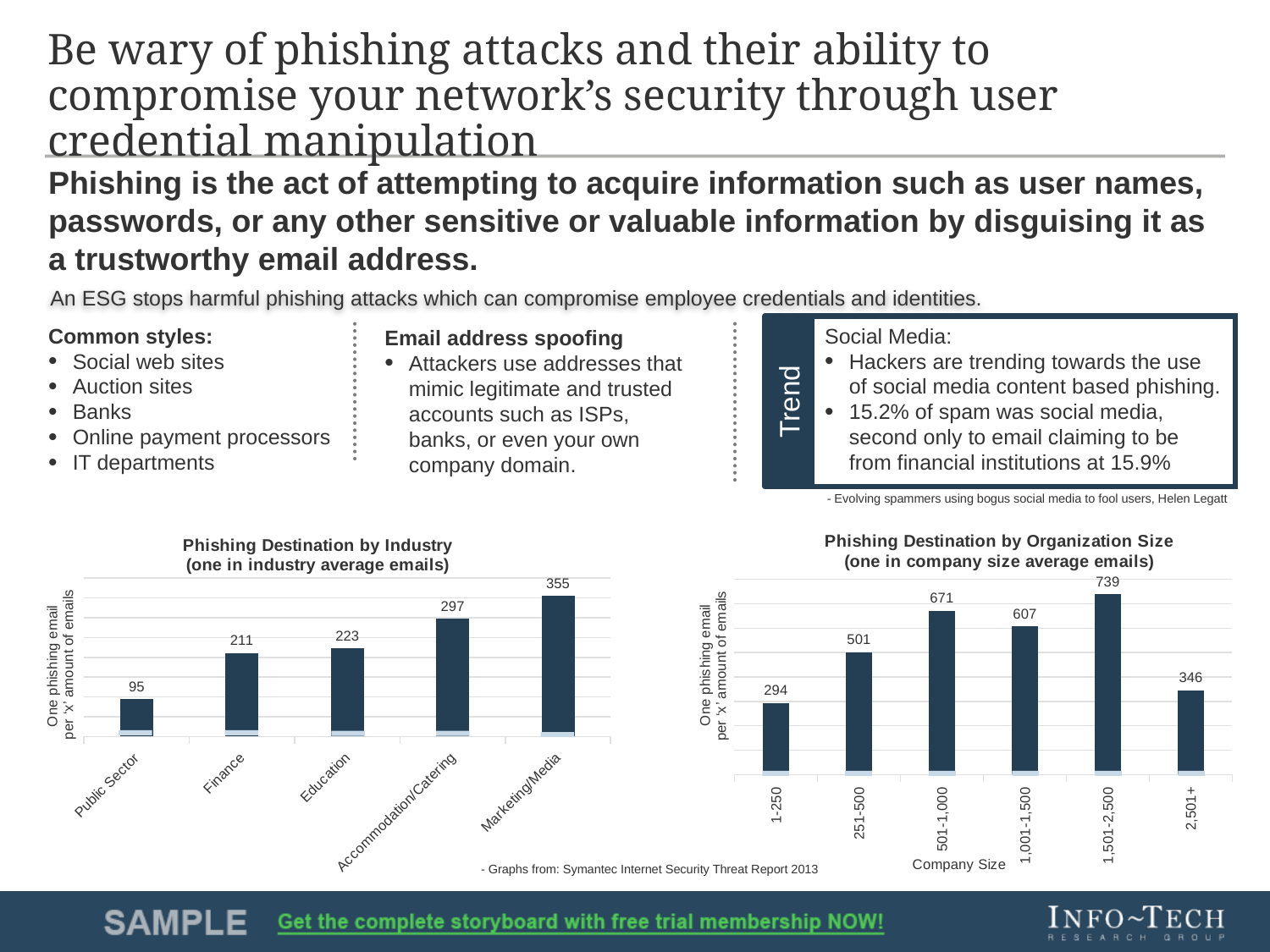
In the 'Phishing Destination by Organization Size' chart, what is the value for the 1,001-1,500 company size? 607 In the 'Phishing Destination by Organization Size' chart, which company size has the lowest value? 1-250 In the 'Phishing Destination by Industry' chart, what is the difference between Marketing/Media and Accommodation/Catering? 58 What type of chart is 'Phishing Destination by Organization Size'? bar chart In the 'Phishing Destination by Organization Size' chart, which is larger, the value for 501-1,000 or the value for 2,501+? 501-1,000 In the 'Phishing Destination by Industry' chart, which industry has the highest value? Marketing/Media In the 'Phishing Destination by Industry' chart, which industry has the lowest value? Public Sector In the 'Phishing Destination by Organization Size' chart, what is the difference between the 1,501-2,500 and 1-250 values? 445 In the 'Phishing Destination by Industry' chart, how many industries are shown? 5 In the 'Phishing Destination by Industry' chart, do the values rise or fall from Public Sector to Marketing/Media? rise In the 'Phishing Destination by Industry' chart, what is the value for Finance? 211 In the 'Phishing Destination by Organization Size' chart, which company size has the highest value? 1,501-2,500